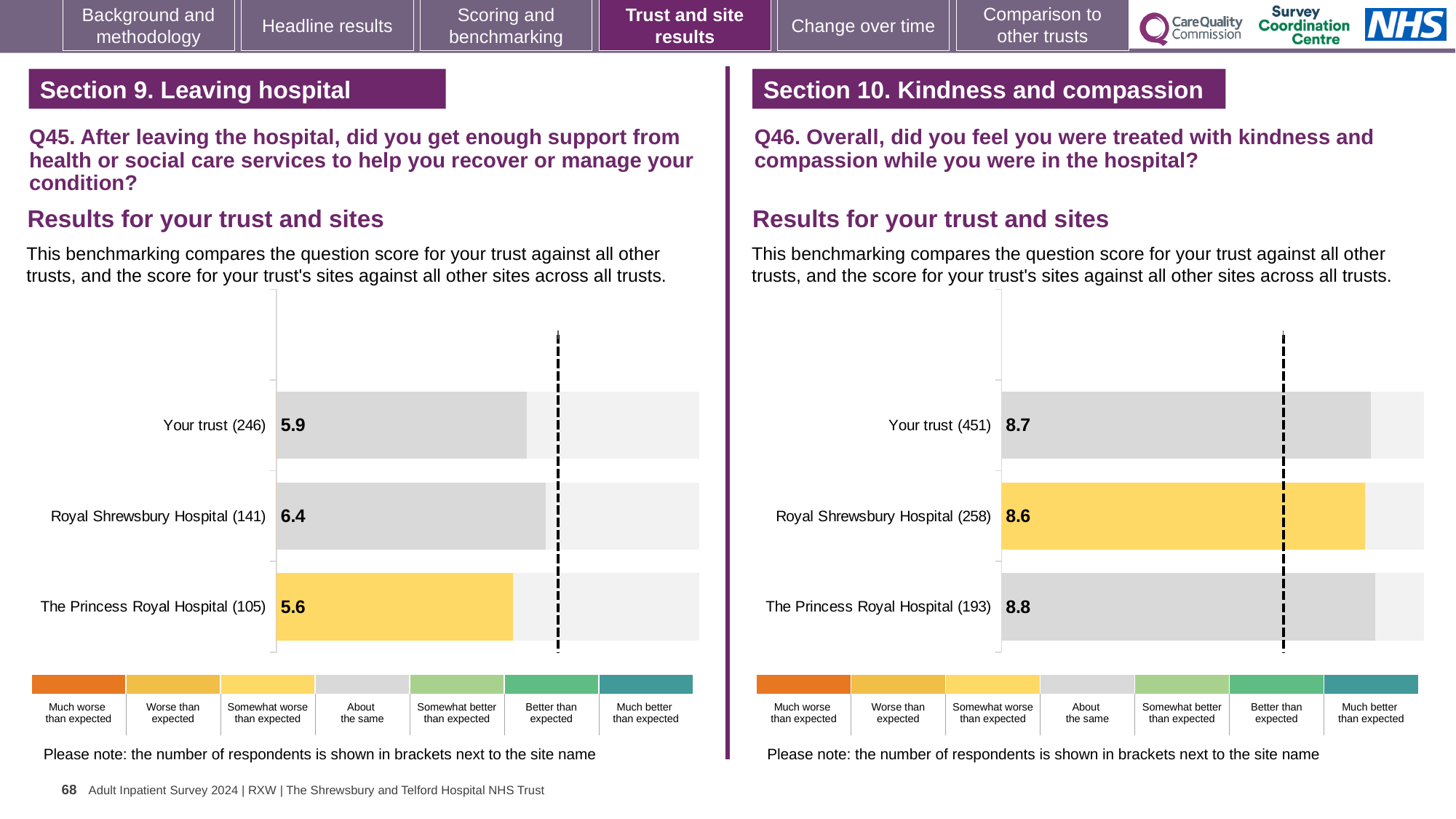
In the Q46 chart on the right, what is the score for Your trust? 8.7 What type of chart is used for the Q46 results on the right? Bar chart How many bars are plotted in the Q45 chart on the left? 3 In the Q46 chart on the right, how many respondents are shown for Your trust? 451 In the Q45 chart on the left, how many respondents are shown for The Princess Royal Hospital? 105 In the Q45 chart on the left, which site or trust has the lowest score? The Princess Royal Hospital In the Q46 chart on the right, which site or trust has the highest score? The Princess Royal Hospital In the Q45 chart on the left, what is the score for Your trust? 5.9 In the Q45 chart on the left, what is the difference between the scores for Royal Shrewsbury Hospital and The Princess Royal Hospital? 0.8 In the Q45 chart on the left, what is the score for Royal Shrewsbury Hospital? 6.4 In the Q46 chart on the right, what is the difference between the scores for The Princess Royal Hospital and Royal Shrewsbury Hospital? 0.2 In the Q46 chart on the right, what is the score for The Princess Royal Hospital? 8.8